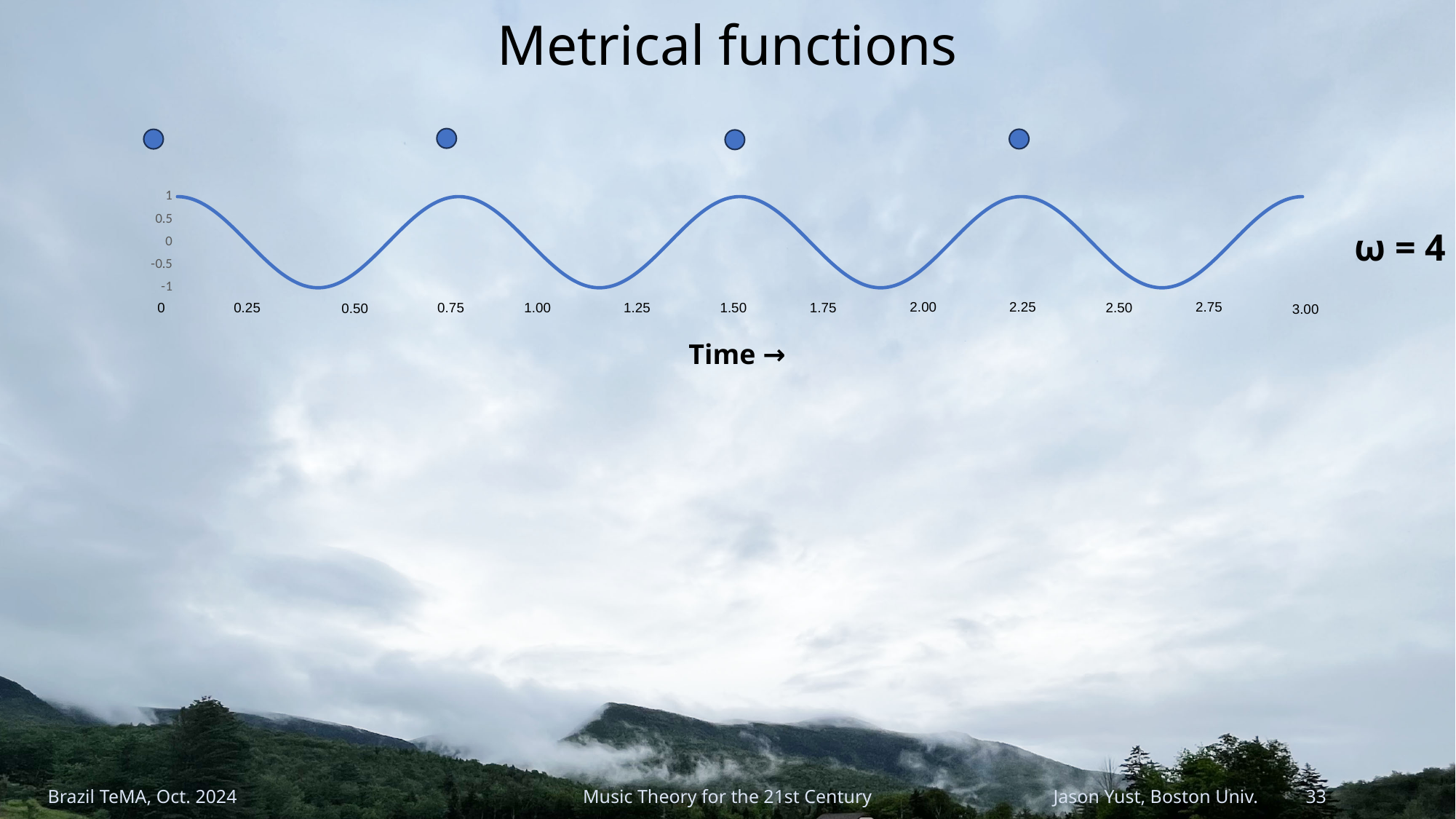
How many tick labels are shown on the x axis of the chart? 13 Does the curve rise or fall between time 0 and time 0.25? fall What is the value of the curve at time 3.00? 1 Is the value of the curve at time 1.00 greater or less than 0? less What is the title of the slide containing the chart? Metrical functions What kind of chart is shown on the slide? line chart Is the value of the curve at time 2.25 greater or less than 0.5? greater Which is larger, the value of the curve at time 0.75 or at time 1.00? 0.75 What label is shown beneath the x axis of the chart? Time → What is the value of the curve at time 1.50? 1 What is the value of the curve at time 0? 1